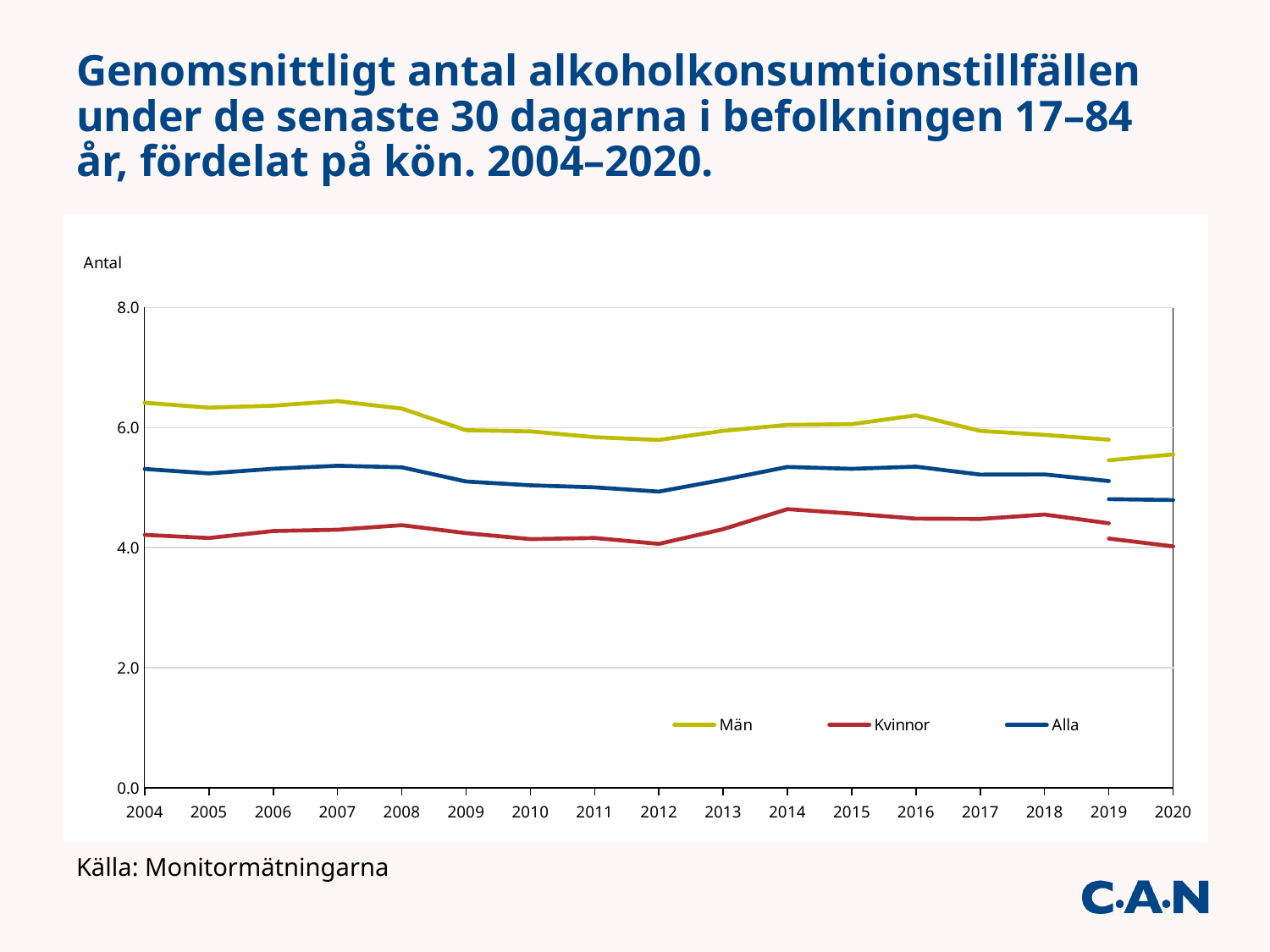
How many years are plotted along the x axis? 17 What kind of chart is shown on the slide? line chart Which series has the lowest values throughout the period? Kvinnor In 2010, which is larger, the value for Män or the value for Kvinnor? Män Is the value for Män in 2020 greater or less than 6.0? less How many series does the legend list? 3 Is the value for Alla in 2020 greater or less than 6.0? less Is the value for Kvinnor in 2014 greater or less than 4.0? greater Does the Män series rise or fall between 2007 and 2012? fall What is the label on the y axis? Antal Which series has the highest values throughout the period? Män